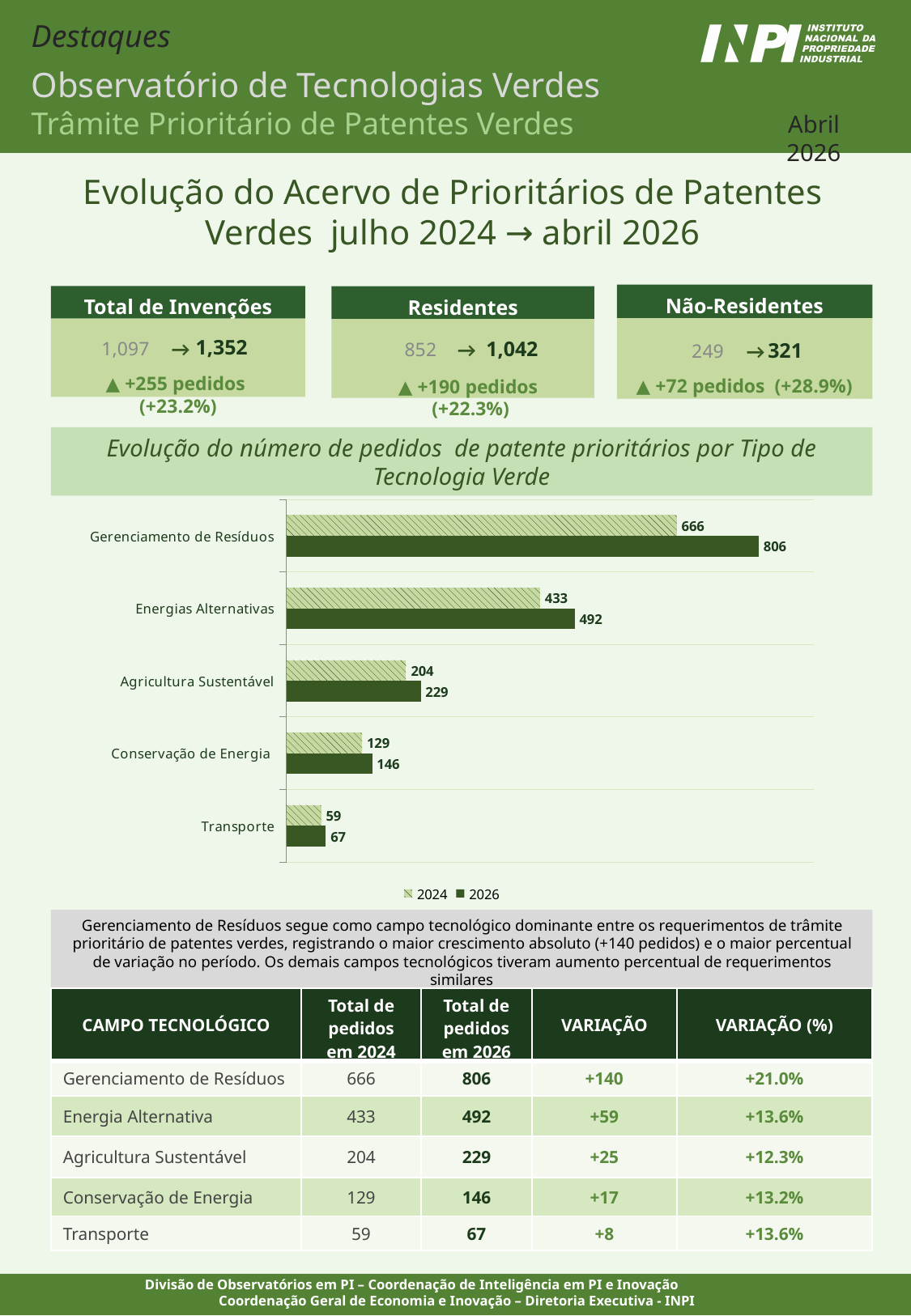
How many categories are plotted in the bar chart? 5 What is the 2024 value for Energias Alternativas in the bar chart? 433 What is the difference between the 2026 values for Gerenciamento de Resíduos and Energias Alternativas in the bar chart? 314 Which category has the highest 2026 value in the bar chart? Gerenciamento de Resíduos In the bar chart, which is larger: the 2026 value for Conservação de Energia or the 2024 value for Agricultura Sustentável? 2024 value for Agricultura Sustentável How many series does the chart legend list? 2 What kind of chart is shown under the heading "Evolução do número de pedidos de patente prioritários por Tipo de Tecnologia Verde"? Bar chart What is the 2026 value for Transporte in the bar chart? 67 What is the 2026 value for Gerenciamento de Resíduos in the bar chart? 806 Which category has the lowest 2024 value in the bar chart? Transporte Which series in the bar chart is drawn with a hatched pattern? 2024 What is the difference between the 2026 and 2024 values for Agricultura Sustentável in the bar chart? 25